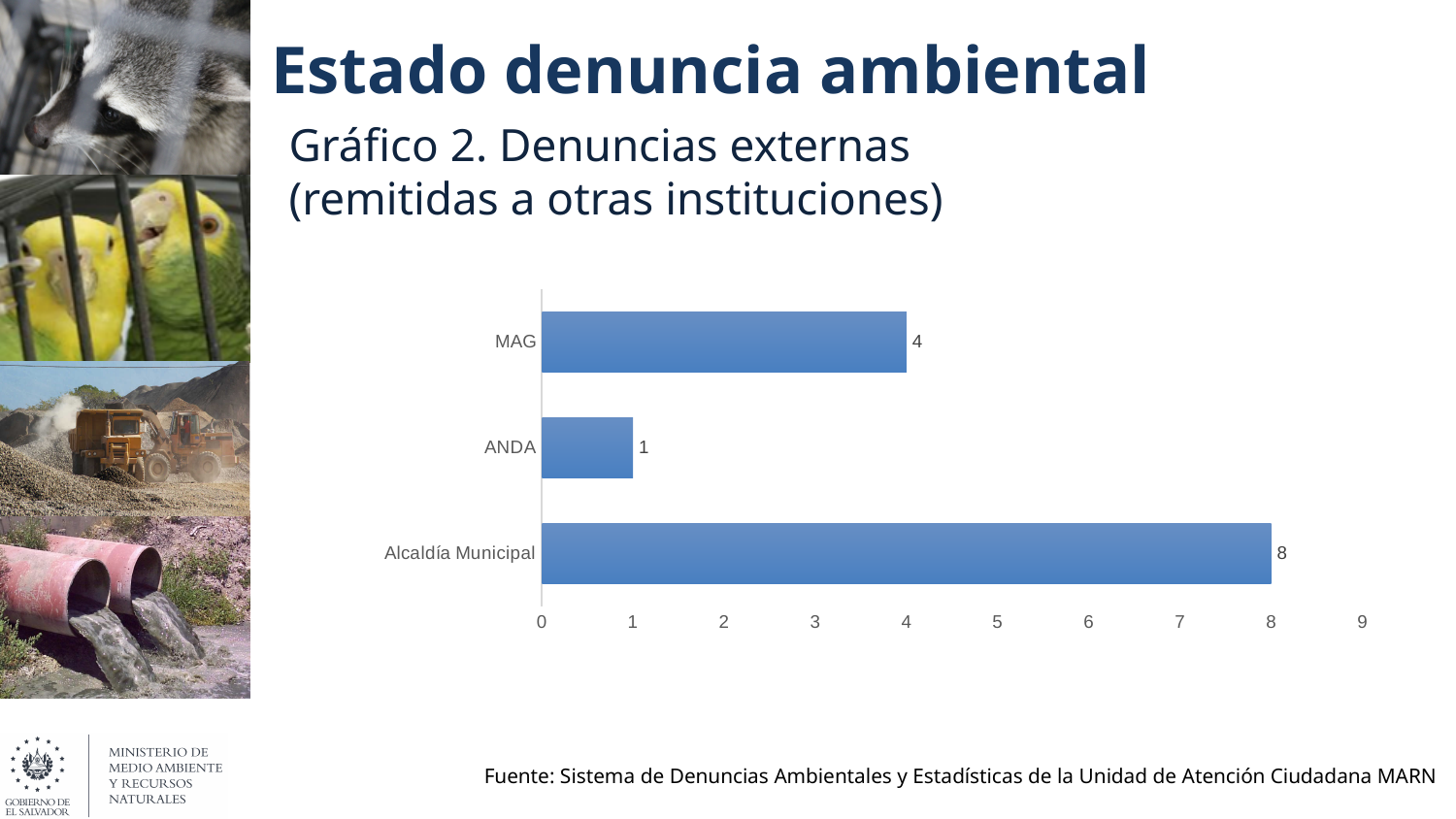
Is the value for Alcaldía Municipal greater or less than 5? greater What kind of chart is shown on the slide? bar chart Which category has the lowest value? ANDA What is the value for ANDA? 1 What is the title of the chart? Gráfico 2. Denuncias externas (remitidas a otras instituciones) What is the difference between the values for Alcaldía Municipal and MAG? 4 How many categories are shown in the chart? 3 What is the value for MAG? 4 What is the value for Alcaldía Municipal? 8 Which is larger, the value for MAG or the value for ANDA? MAG Which category has the highest value? Alcaldía Municipal What is the difference between the values for MAG and ANDA? 3